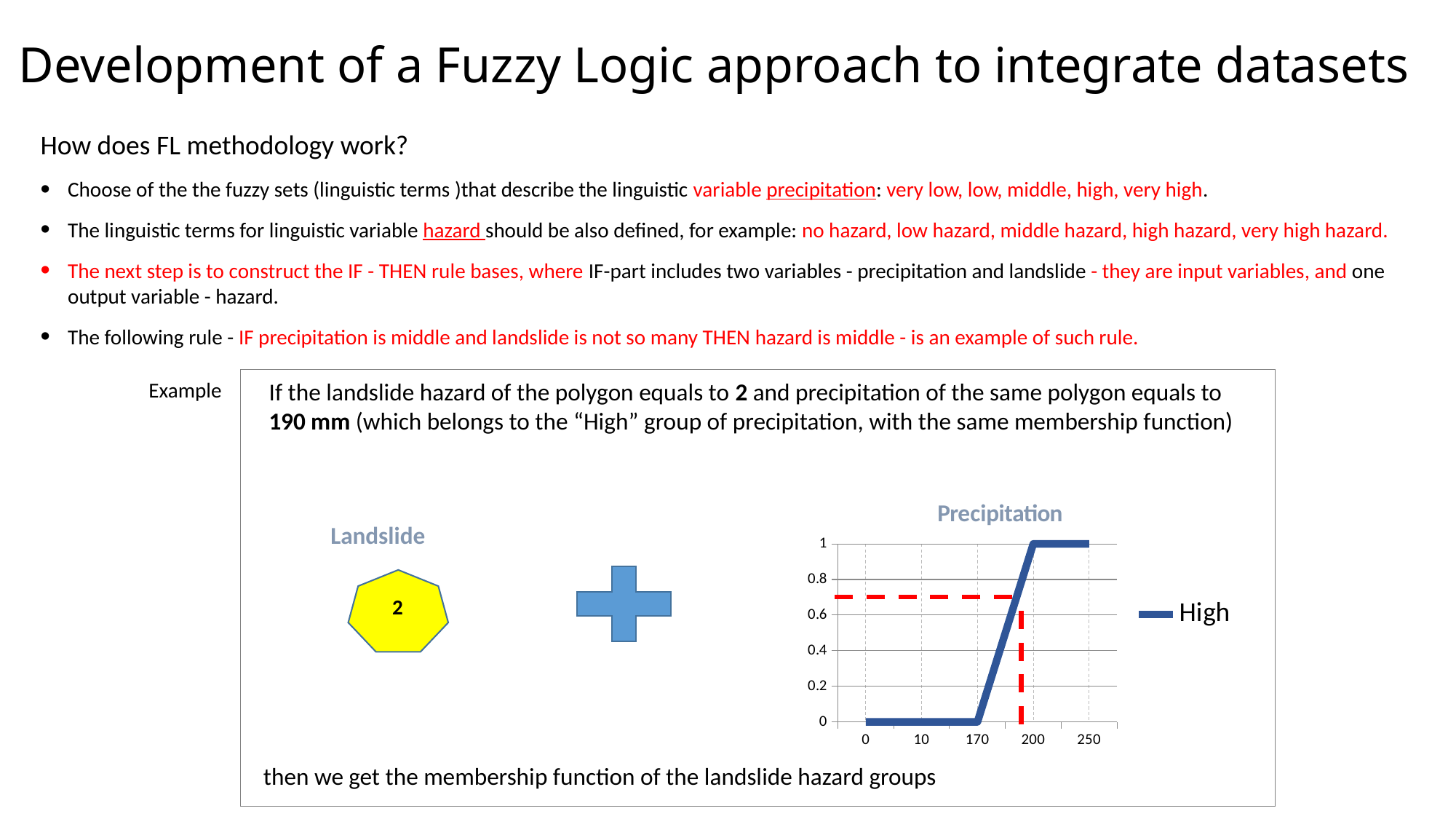
How many x-axis tick labels are shown on the Precipitation chart? 5 In the Precipitation chart, what is the value of the High series at x = 10? 0 What is the name of the series shown in the legend of the Precipitation chart? High What kind of chart is the Precipitation chart? line chart In the Precipitation chart, what is the value of the High series at x = 200? 1 In the Precipitation chart, what is the value of the High series at x = 170? 0 In the Precipitation chart, what is the value of the High series at x = 250? 1 What is the title of the chart on the slide? Precipitation In the Precipitation chart, does the High series rise or fall between x = 170 and x = 200? rise In the Precipitation chart, what is the difference between the High value at x = 200 and at x = 170? 1 In the Precipitation chart, which is larger: the High value at x = 200 or at x = 170? x = 200 How many series does the legend of the Precipitation chart list? 1